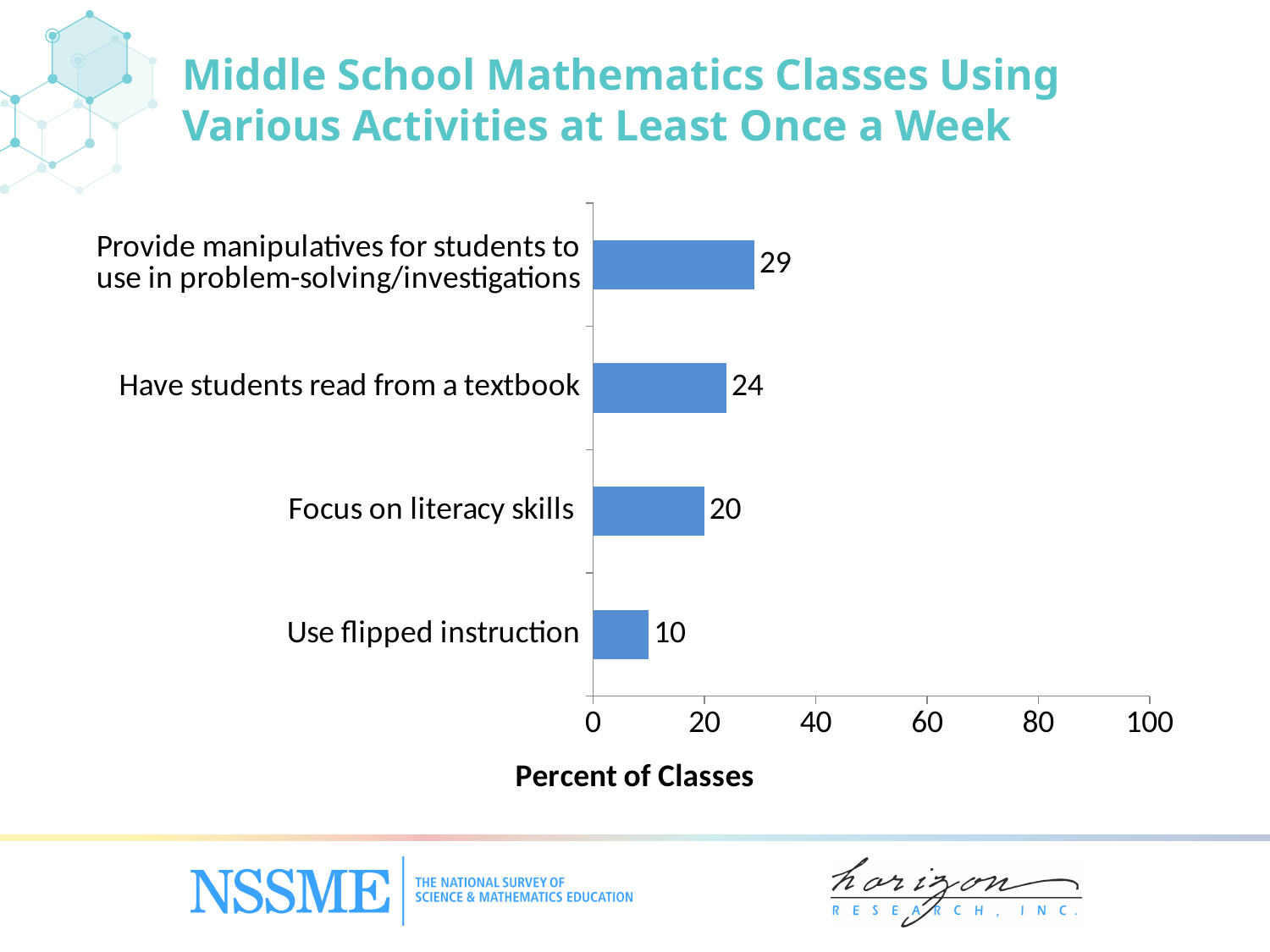
Which activity has the highest percent of classes? Provide manipulatives for students to use in problem-solving/investigations Which has a higher percent of classes: having students read from a textbook or focusing on literacy skills? Have students read from a textbook How many activities are shown in the chart? 4 What percent of classes have students read from a textbook at least once a week? 24 Which activity has the lowest percent of classes? Use flipped instruction What kind of chart is shown on the slide? Bar chart What is the difference in percent of classes between providing manipulatives and using flipped instruction? 19 What percent of classes use flipped instruction at least once a week? 10 What percent of classes focus on literacy skills at least once a week? 20 What is the difference in percent of classes between having students read from a textbook and focusing on literacy skills? 4 What is the label of the horizontal axis? Percent of Classes What percent of classes provide manipulatives for students to use in problem-solving/investigations at least once a week? 29